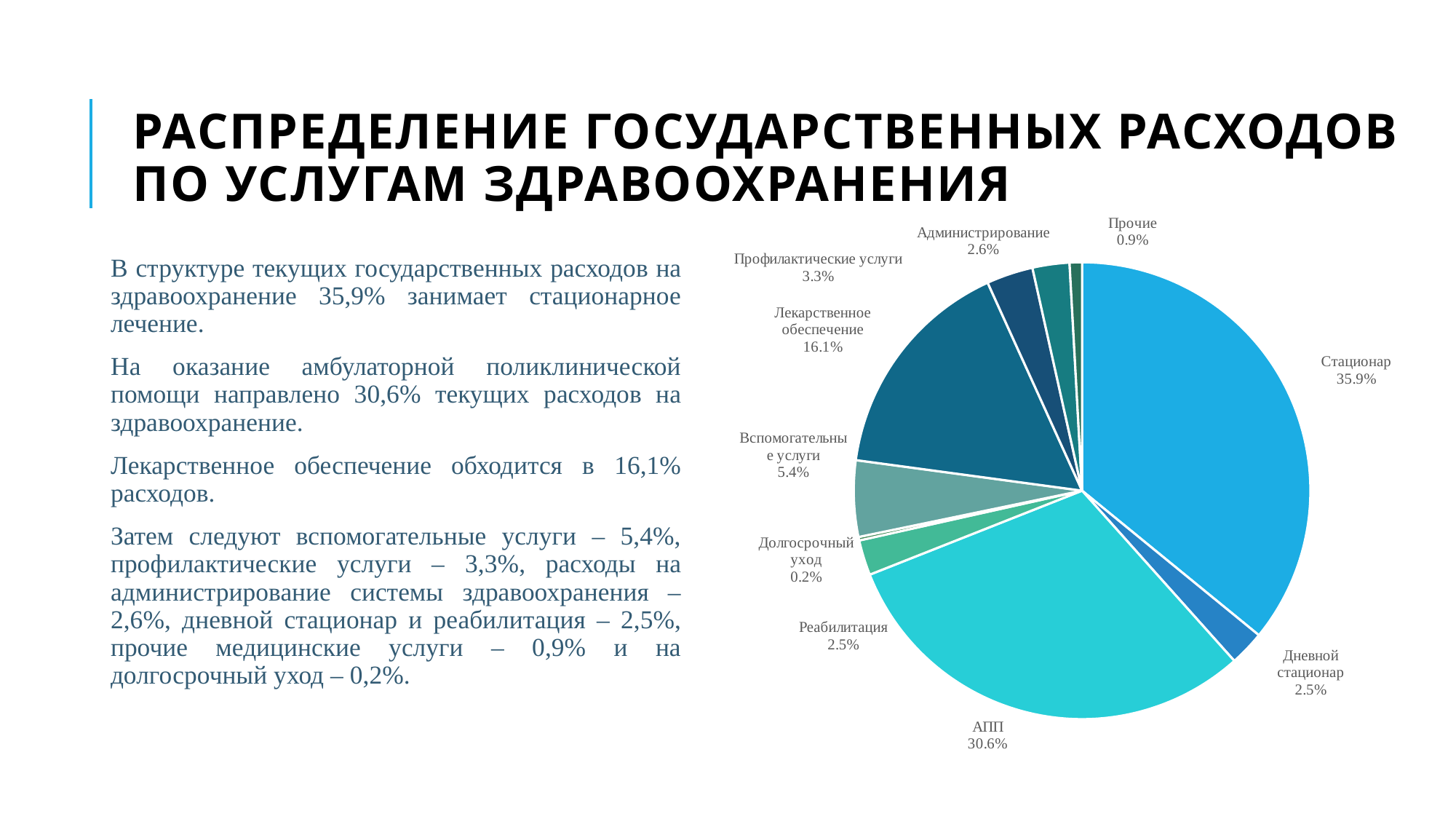
Какая категория занимает наибольшую долю на диаграмме? Стационар Какова суммарная доля секторов «Дневной стационар» и «Реабилитация»? 5.0% Сколько категорий (секторов) показано на круговой диаграмме? 10 Какое значение указано для сектора «АПП»? 30.6% Какой тип диаграммы показан на слайде? Круговая диаграмма Какая категория занимает наименьшую долю на диаграмме? Долгосрочный уход На сколько процентных пунктов доля «Стационар» больше доли «АПП»? 5.3 Какое значение указано для сектора «Администрирование»? 2.6% Какую долю на круговой диаграмме занимает «Стационар»? 35.9% Что больше: доля «Вспомогательные услуги» или доля «Профилактические услуги»? Вспомогательные услуги Какая доля указана для сектора «Прочие»? 0.9% Какая доля расходов приходится на «Лекарственное обеспечение» по диаграмме? 16.1%